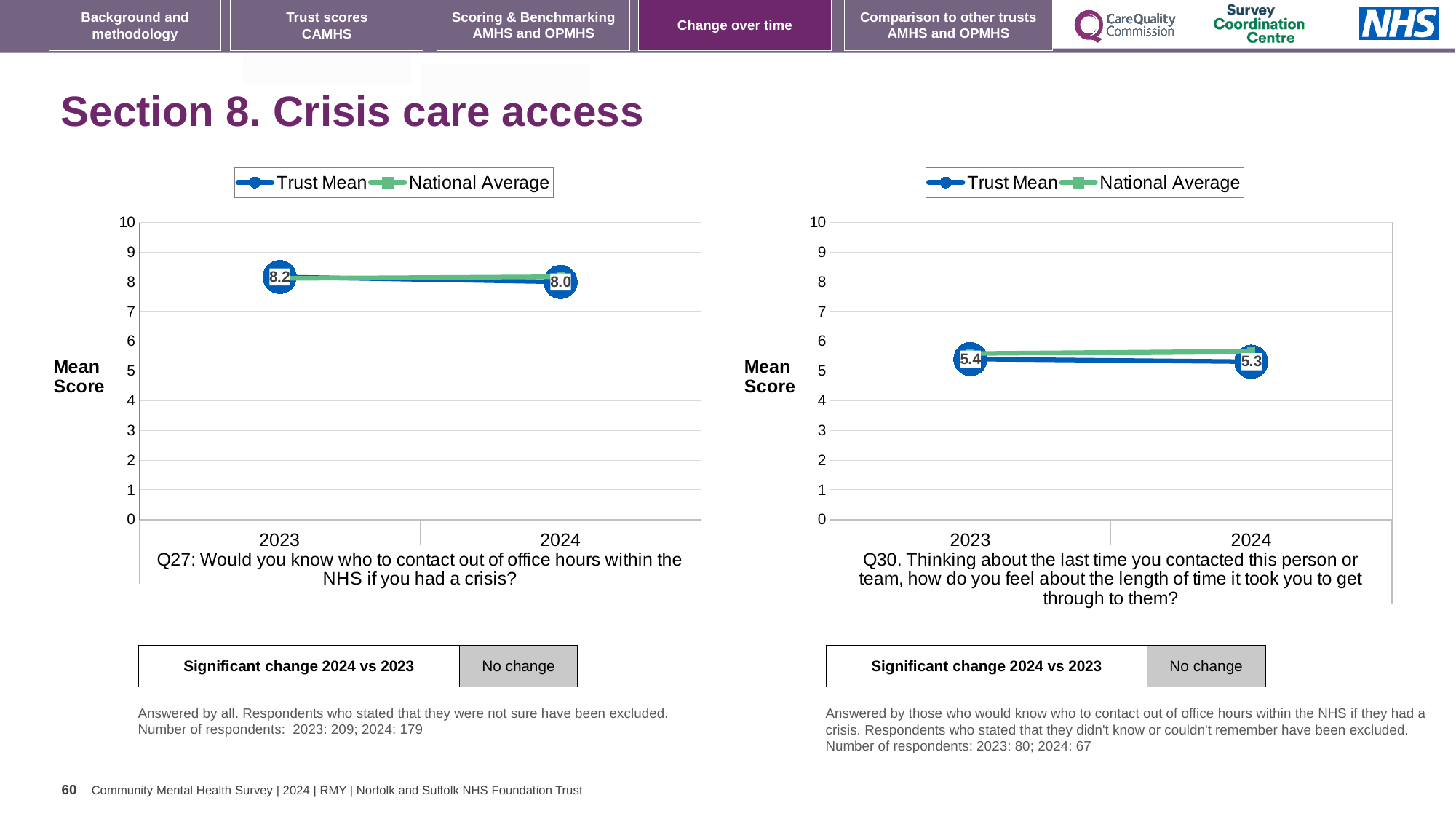
In the left chart (Q27), is the National Average for 2023 greater or less than 7? greater In the right chart (Q30), what is the Trust Mean score for 2023? 5.4 In the right chart (Q30), is the National Average for 2024 greater or less than 5? greater In the left chart (Q27), what is the Trust Mean score for 2024? 8.0 In the right chart (Q30), is the Trust Mean for 2023 higher or lower than for 2024? higher In the right chart (Q30), what is the Trust Mean score for 2024? 5.3 In the right chart (Q30), what is the difference between the Trust Mean for 2023 and 2024? 0.1 How many series does the legend of the right chart (Q30) list? 2 In the left chart (Q27), what is the Trust Mean score for 2023? 8.2 What kind of chart is used for Q27 on the left of the slide? line chart In the left chart (Q27), does the Trust Mean rise or fall from 2023 to 2024? fall In the left chart (Q27), by how much did the Trust Mean change from 2023 to 2024? 0.2